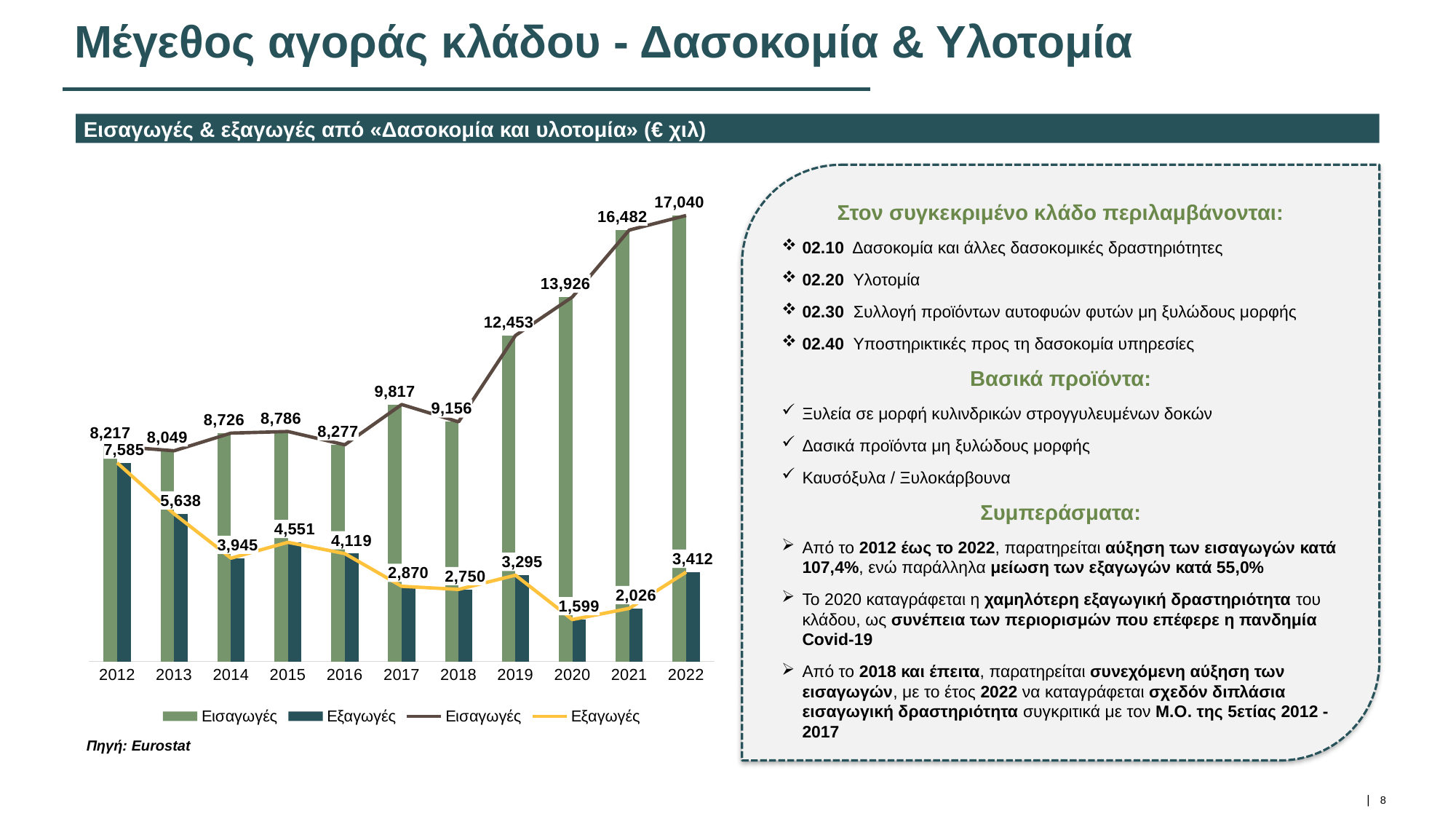
Which is larger in 2019, Εισαγωγές or Εξαγωγές? Εισαγωγές What is the value of Εξαγωγές (exports) in 2020? 1,599 In which year are Εισαγωγές (imports) highest? 2022 In which year are Εξαγωγές (exports) lowest? 2020 What kind of chart is shown on the slide? Combined bar and line chart By how much did Εισαγωγές increase from 2021 to 2022? 558 Do Εισαγωγές (imports) generally rise or fall from 2018 to 2022? Rise How many entries does the chart legend list? 4 What is the value of Εισαγωγές (imports) in 2022? 17,040 What is the difference between Εισαγωγές and Εξαγωγές in 2012? 632 How many years are shown on the x axis of the chart? 11 What is the value of Εισαγωγές in 2017? 9,817